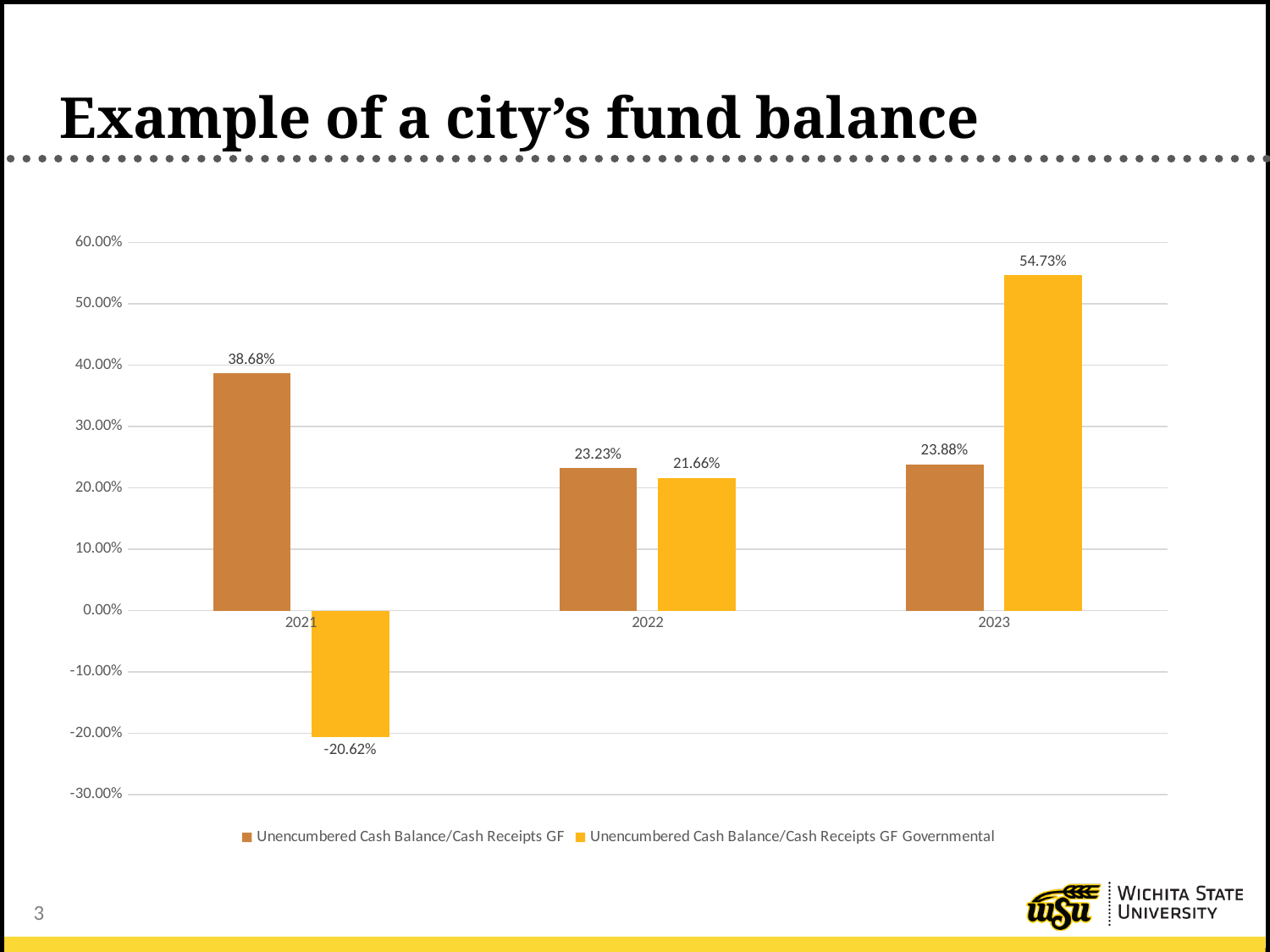
What is the value of Unencumbered Cash Balance/Cash Receipts GF Governmental for 2023? 54.73% Which year has the highest value for Unencumbered Cash Balance/Cash Receipts GF Governmental? 2023 In 2022, which series has the larger value: Unencumbered Cash Balance/Cash Receipts GF or Unencumbered Cash Balance/Cash Receipts GF Governmental? Unencumbered Cash Balance/Cash Receipts GF How many series does the legend list? 2 Which year has the lowest value for Unencumbered Cash Balance/Cash Receipts GF? 2022 What kind of chart is shown on the slide? Bar chart What is the value of Unencumbered Cash Balance/Cash Receipts GF for 2022? 23.23% Does the Unencumbered Cash Balance/Cash Receipts GF Governmental series rise or fall from 2021 to 2023? Rise How many years are shown on the x axis? 3 What is the value of Unencumbered Cash Balance/Cash Receipts GF Governmental for 2021? -20.62% What is the difference between the Unencumbered Cash Balance/Cash Receipts GF Governmental value and the Unencumbered Cash Balance/Cash Receipts GF value in 2023? 30.85% What is the value of Unencumbered Cash Balance/Cash Receipts GF for 2021? 38.68%